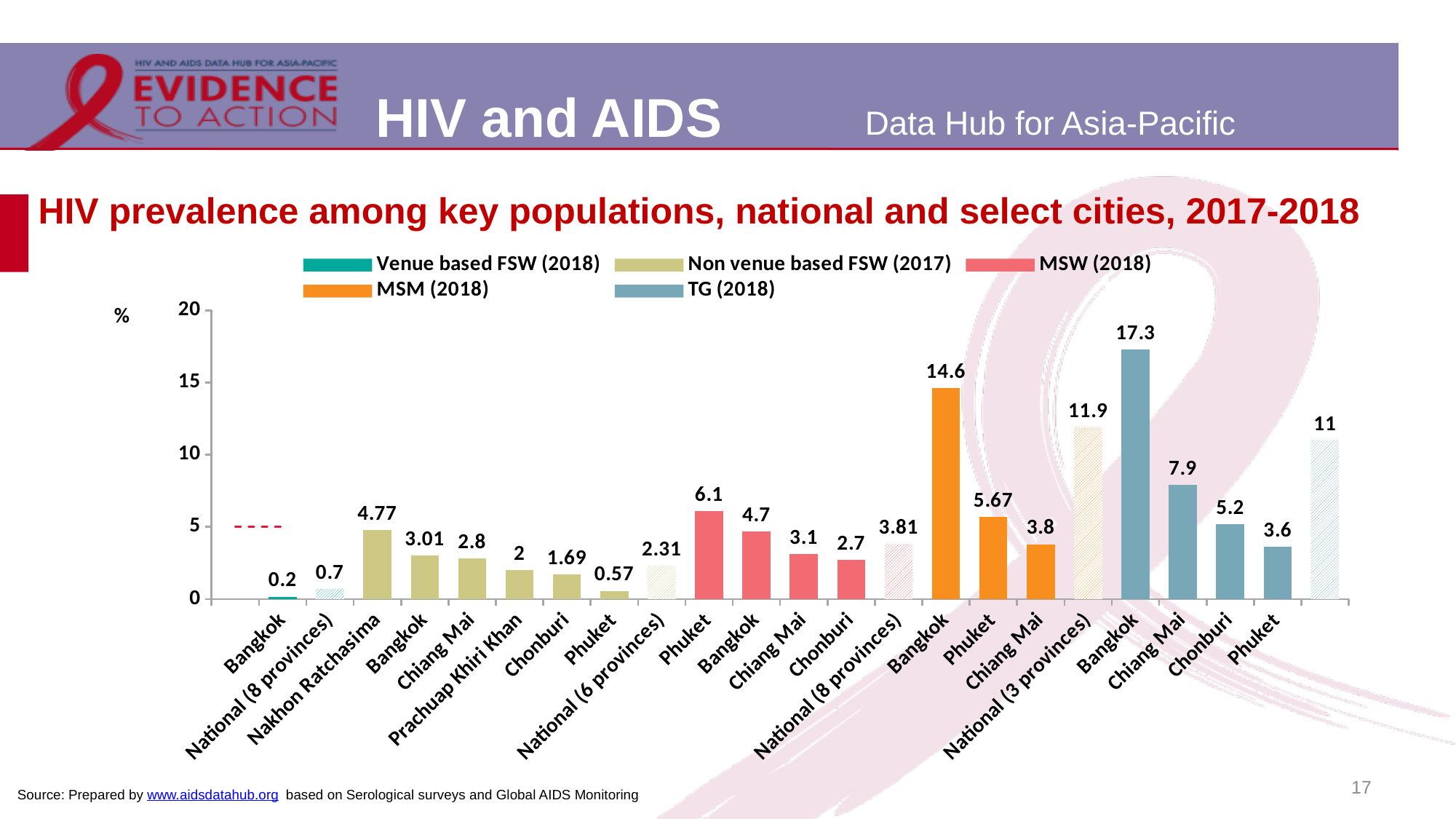
Is the value for National (3 provinces) in the MSM (2018) series greater or less than 10? greater What is the value for Nakhon Ratchasima in the Non venue based FSW (2017) series? 4.77 What is the HIV prevalence value for Bangkok in the TG (2018) series? 17.3 Which is larger: the Phuket value in the MSW (2018) series or the Phuket value in the MSM (2018) series? Phuket in MSW (2018) What is the value for National (8 provinces) in the MSW (2018) series? 3.81 What is the HIV prevalence value for Bangkok in the MSM (2018) series? 14.6 What kind of chart is shown on the slide? Bar chart Which bar has the highest value on the chart? Bangkok, TG (2018) How many series does the legend list? 5 What is the title of the chart? HIV prevalence among key populations, national and select cities, 2017-2018 Which bar has the lowest value on the chart? Bangkok, Venue based FSW (2018) What is the difference between the Bangkok value in the TG (2018) series and the Bangkok value in the MSM (2018) series? 2.7